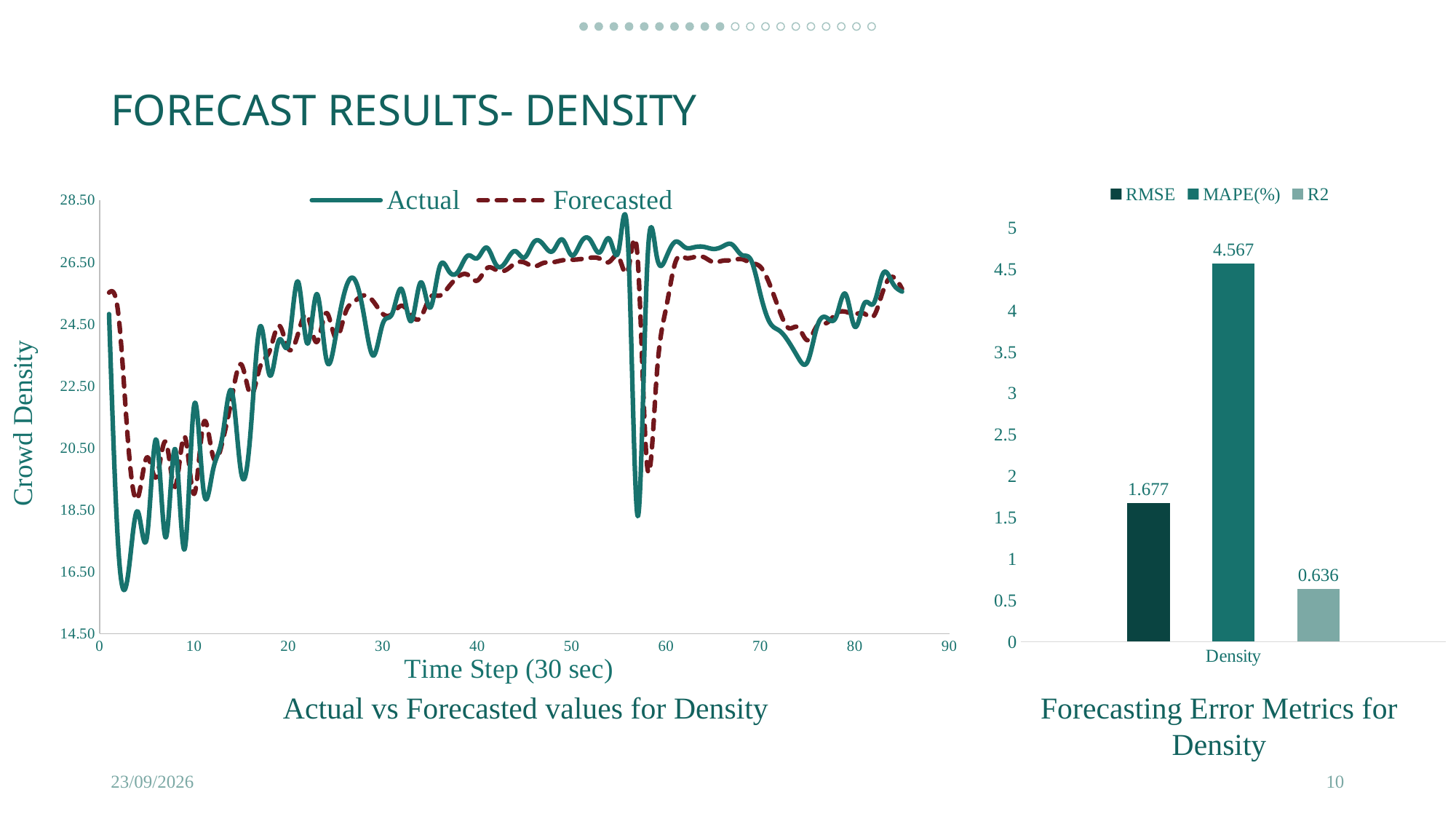
In the 'Forecasting Error Metrics for Density' chart, which metric has the lowest value? R2 In the 'Forecasting Error Metrics for Density' chart, what is the difference between the MAPE(%) value and the RMSE value? 2.890 In the 'Forecasting Error Metrics for Density' chart, which metric has the highest value? MAPE(%) What is the x-axis label of the 'Actual vs Forecasted values for Density' chart? Time Step (30 sec) How many series does the legend of the 'Forecasting Error Metrics for Density' chart list? 3 In the 'Forecasting Error Metrics for Density' chart, what is the value of MAPE(%)? 4.567 In the 'Forecasting Error Metrics for Density' chart, what is the value of R2? 0.636 How many series does the legend of the 'Actual vs Forecasted values for Density' chart list? 2 In the 'Forecasting Error Metrics for Density' chart, what is the value of RMSE? 1.677 In the 'Forecasting Error Metrics for Density' chart, which is larger, RMSE or R2? RMSE What kind of chart is the 'Actual vs Forecasted values for Density' chart? Line chart What kind of chart is the 'Forecasting Error Metrics for Density' chart? Bar chart